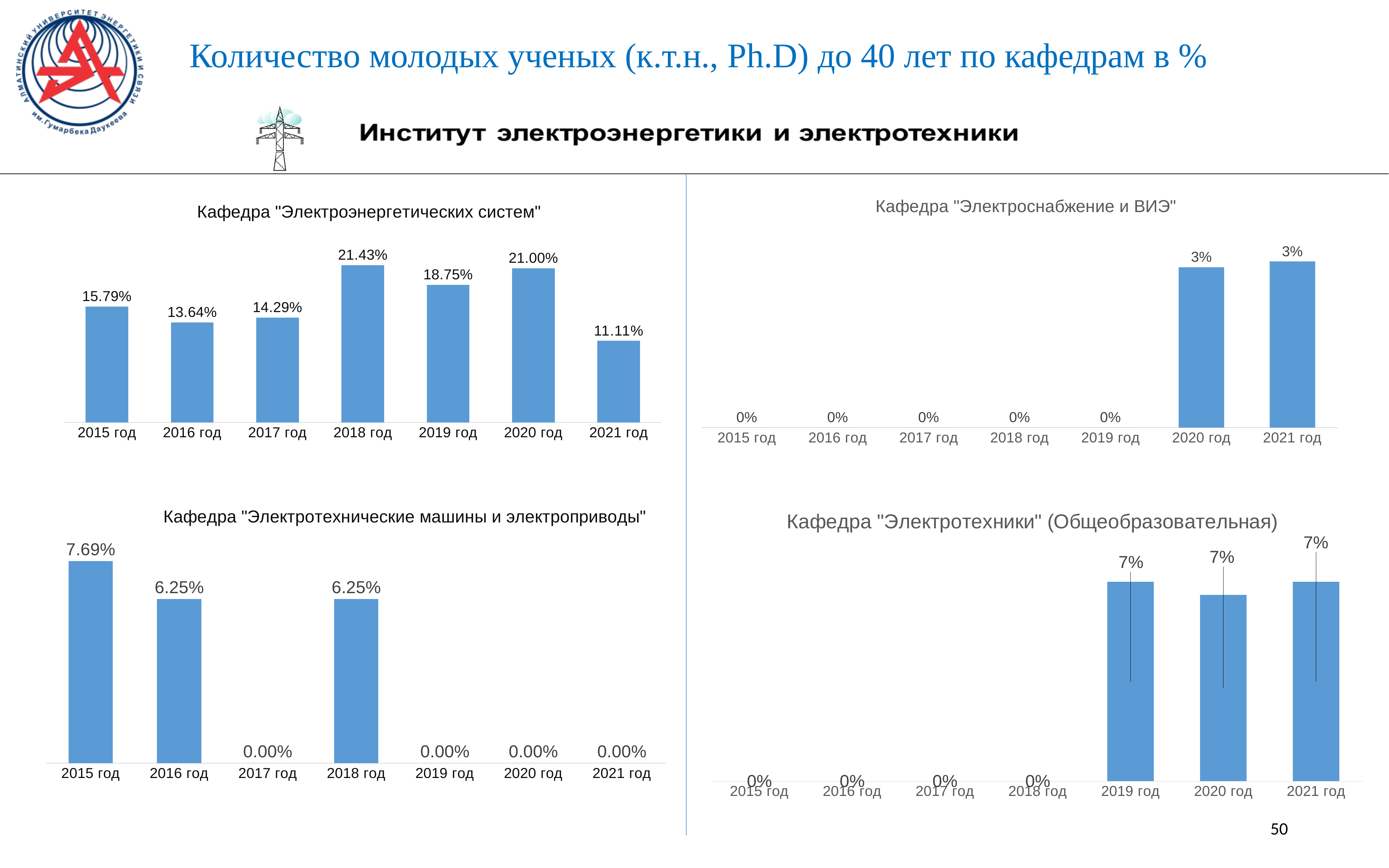
In the chart "Кафедра "Электроснабжение и ВИЭ"", what is the value for 2020 год? 3% In the chart "Кафедра "Электроэнергетических систем"", what is the value for 2018 год? 21.43% In the chart "Кафедра "Электротехники" (Общеобразовательная)", what is the value for 2021 год? 7% In the chart "Кафедра "Электроэнергетических систем"", which year has the lowest value? 2021 год In the chart "Кафедра "Электротехнические машины и электроприводы"", what is the value for 2015 год? 7.69% In the chart "Кафедра "Электротехнические машины и электроприводы"", what is the difference between the values for 2015 год and 2016 год? 1.44% In the chart "Кафедра "Электроэнергетических систем"", which year has the highest value? 2018 год In the chart "Кафедра "Электротехнические машины и электроприводы"", what is the value for 2017 год? 0.00% In the chart "Кафедра "Электроэнергетических систем"", which is larger, the value for 2016 год or 2017 год? 2017 год How many charts are shown on the slide, and what type are they? 4 bar charts In the chart "Кафедра "Электроснабжение и ВИЭ"", how many years show a value of 0%? 5 In the chart "Кафедра "Электроэнергетических систем"", what is the difference between the values for 2019 год and 2021 год? 7.64%